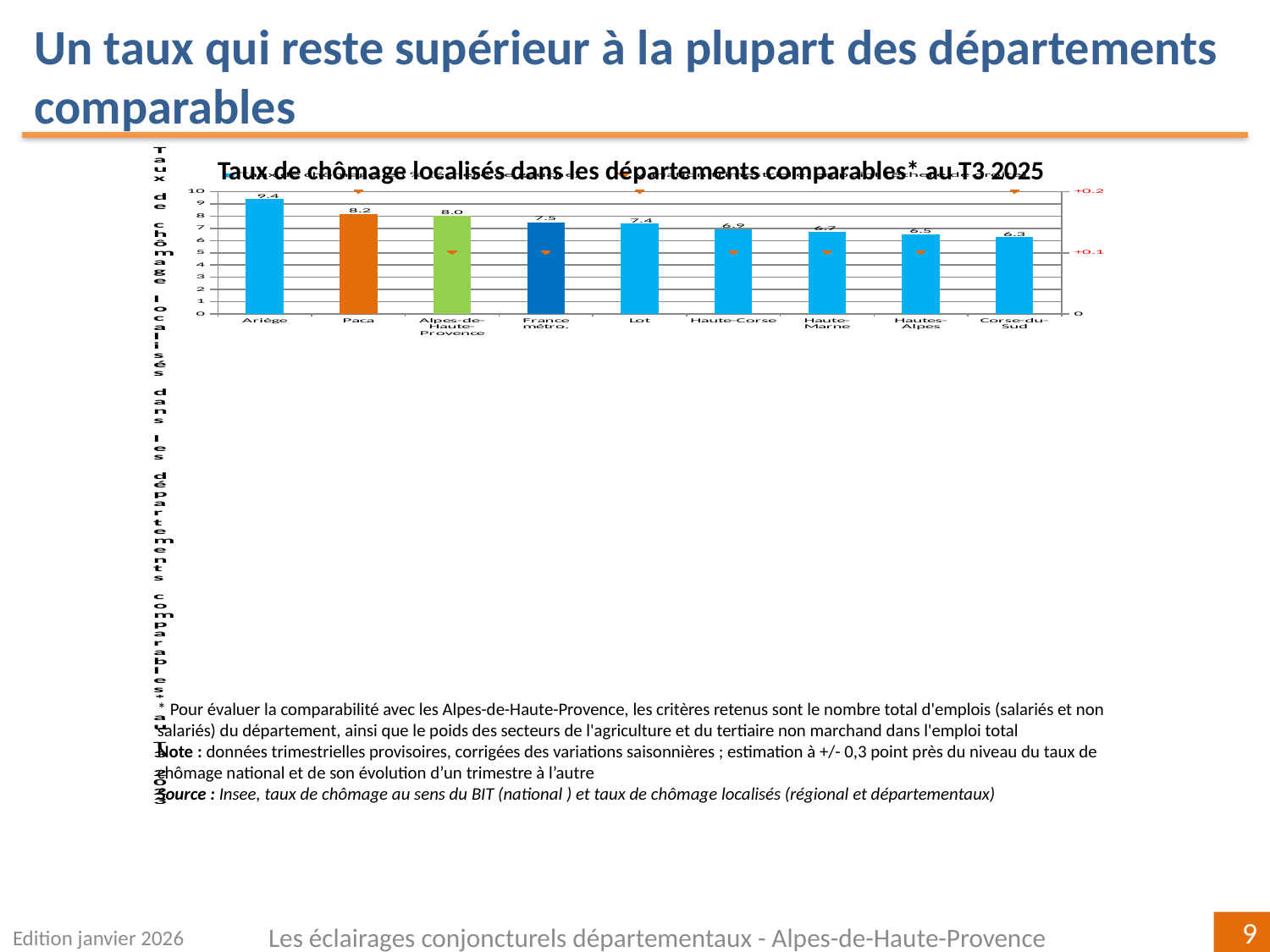
Is the value for Haute-Marne greater or less than 5? greater What is the unemployment rate shown for Ariège? 9.4 Do the bar values rise or fall from left to right along the x axis? fall Which category has the highest unemployment rate? Ariège What kind of chart is shown on the slide? bar chart Which category has the lowest unemployment rate? Corse-du-Sud What is the difference between the values for Ariège and Alpes-de-Haute-Provence? 1.4 What is the value shown for France métro.? 7.5 What is the value shown for Alpes-de-Haute-Provence? 8.0 How many categories are shown on the x axis? 9 What is the value shown for Corse-du-Sud? 6.3 Which is larger, the value for Paca or the value for Lot? Paca